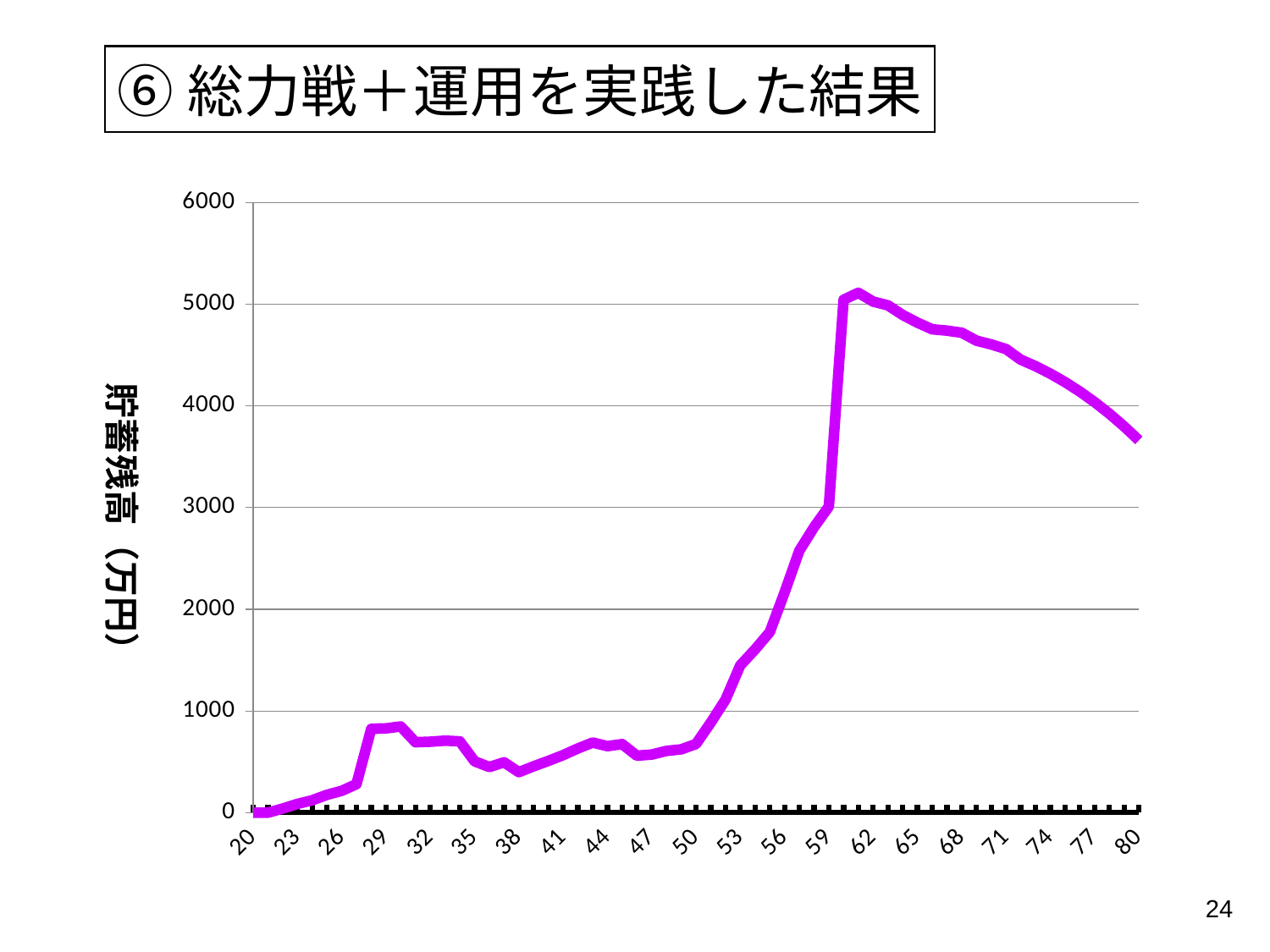
How many age labels are shown along the x axis? 21 What is the title of the slide containing the chart? ⑥ 総力戦＋運用を実践した結果 Which is larger, the value at age 62 or the value at age 80? age 62 Which is larger, the value at age 29 or the value at age 38? age 29 Does the value rise or fall between age 62 and age 80? fall Is the value at age 29 greater or less than 1000? less What kind of chart is shown on the slide? line chart Does the value rise or fall between age 50 and age 62? rise Is the value at age 80 greater or less than 4000? less Is the value at age 65 greater or less than 4000? greater What is the label of the vertical axis? 貯蓄残高（万円）